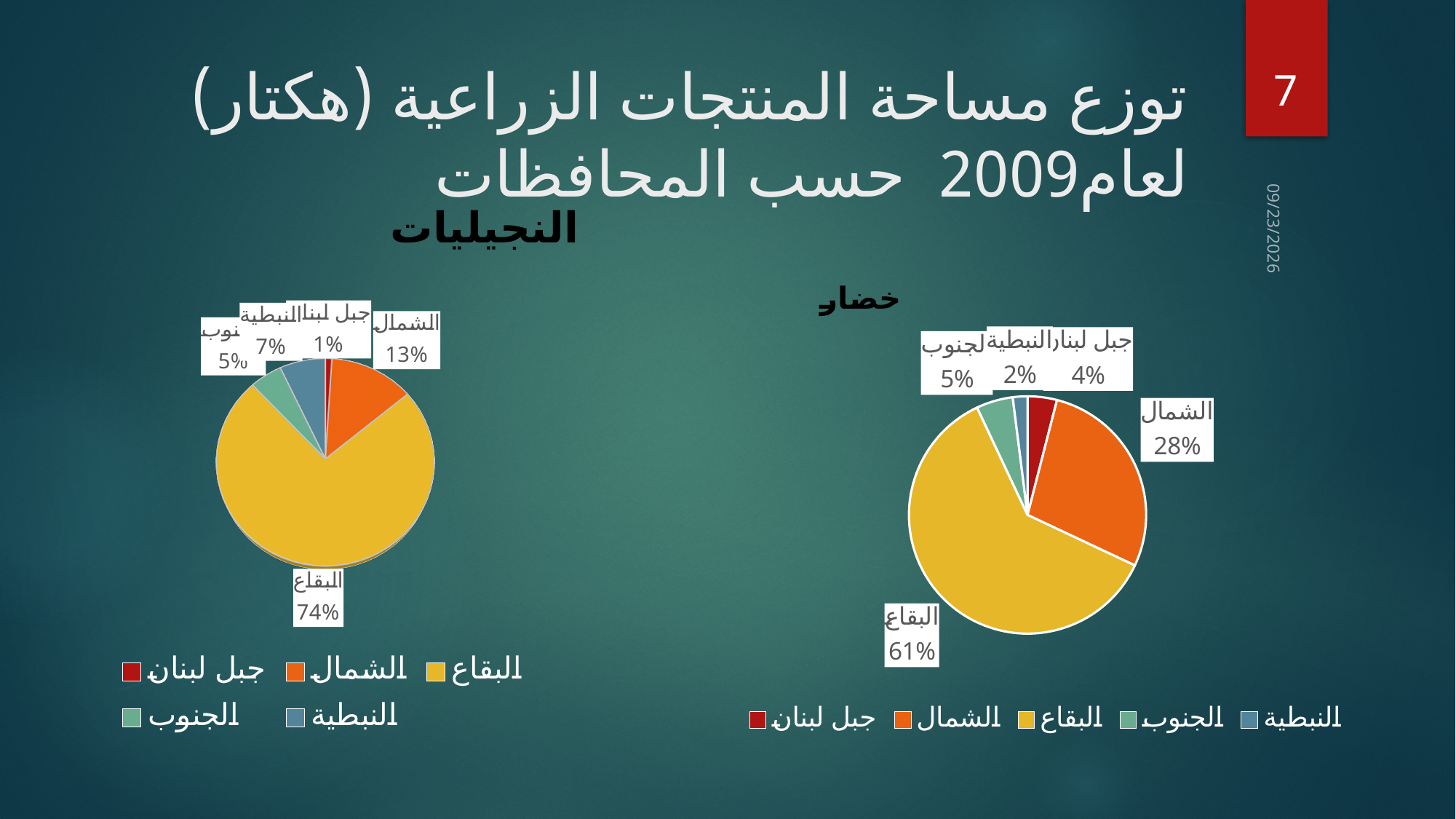
How many slices does the النجيليات chart on the left have? 5 In the خضار chart on the right, what share does الشمال have? 28% In the النجيليات chart on the left, what share does البقاع have? 74% In the خضار chart on the right, which region has the largest share? البقاع How many entries does the legend of the خضار chart on the right list? 5 In the النجيليات chart on the left, which region has the smallest share? جبل لبنان In the خضار chart on the right, which is larger, the share of الجنوب or the share of جبل لبنان? الجنوب In the خضار chart on the right, what share does النبطية have? 2% In the النجيليات chart on the left, what is the difference between the shares of النبطية and الجنوب? 2% In the النجيليات chart on the left, what share does الشمال have? 13% In the خضار chart on the right, what is the difference between the shares of البقاع and الشمال? 33% What type of chart is used for the النجيليات chart on the left? pie chart